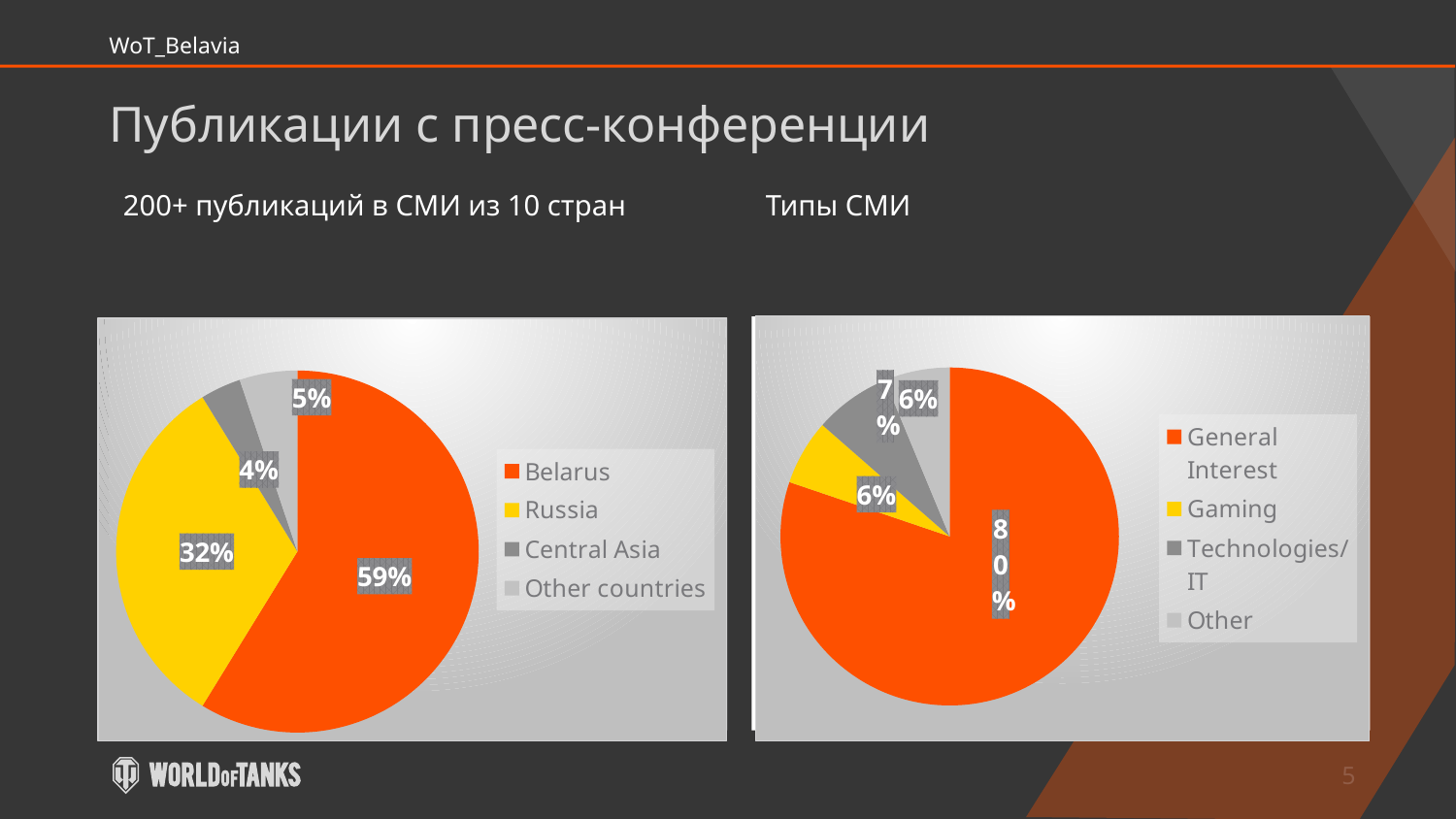
What type of chart is used on the right side of the slide? Pie chart On the left pie chart, what share does Belarus have? 59% On the right pie chart (Типы СМИ), which category has the largest share? General Interest On the right pie chart (Типы СМИ), what share does Technologies/IT have? 7% On the right pie chart (Типы СМИ), which is larger: General Interest or Gaming? General Interest On the left pie chart, how many categories are shown? 4 On the left pie chart, what is the difference between the shares of Belarus and Russia? 27% On the left pie chart, what share does Central Asia have? 4% On the left pie chart, which category has the largest share? Belarus On the left pie chart, which category has the smallest share? Central Asia On the left pie chart, what share does Russia have? 32% On the right pie chart (Типы СМИ), what share does General Interest have? 80%